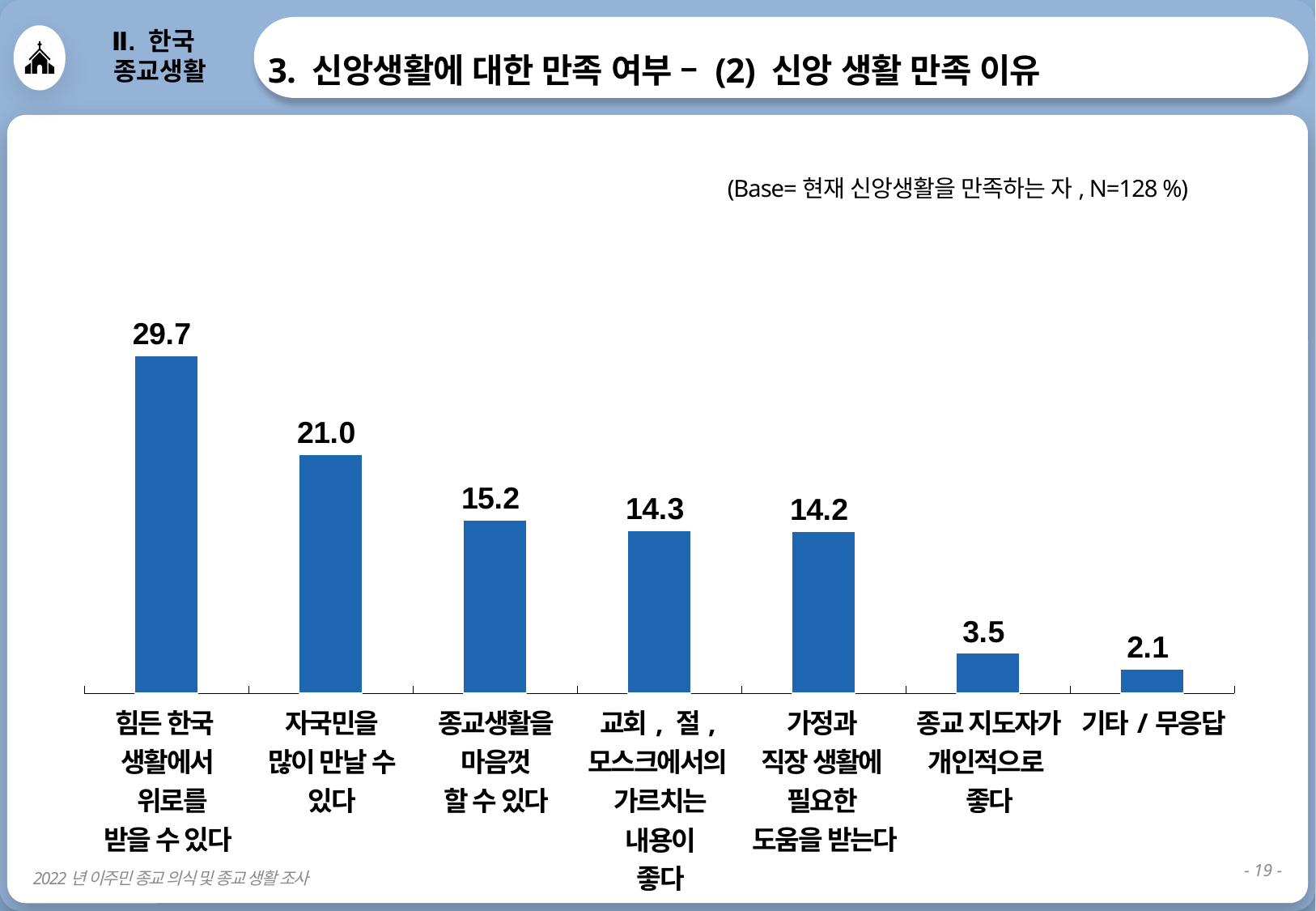
How many categories are shown in the chart? 7 What is the difference between the values for '힘든 한국 생활에서 위로를 받을 수 있다' and '자국민을 많이 만날 수 있다'? 8.7 Which is larger, the value for '종교생활을 마음껏 할 수 있다' or the value for '종교 지도자가 개인적으로 좋다'? 종교생활을 마음껏 할 수 있다 Which category has the lowest value? 기타 / 무응답 What is the value for '힘든 한국 생활에서 위로를 받을 수 있다'? 29.7 What is the value for '자국민을 많이 만날 수 있다'? 21.0 What kind of chart is shown on the slide? Bar chart What is the value for '종교생활을 마음껏 할 수 있다'? 15.2 What is the difference between the values for '교회, 절, 모스크에서의 가르치는 내용이 좋다' and '가정과 직장 생활에 필요한 도움을 받는다'? 0.1 What is the base (N) stated for the chart? N=128 What is the value for '종교 지도자가 개인적으로 좋다'? 3.5 Which category has the highest value? 힘든 한국 생활에서 위로를 받을 수 있다